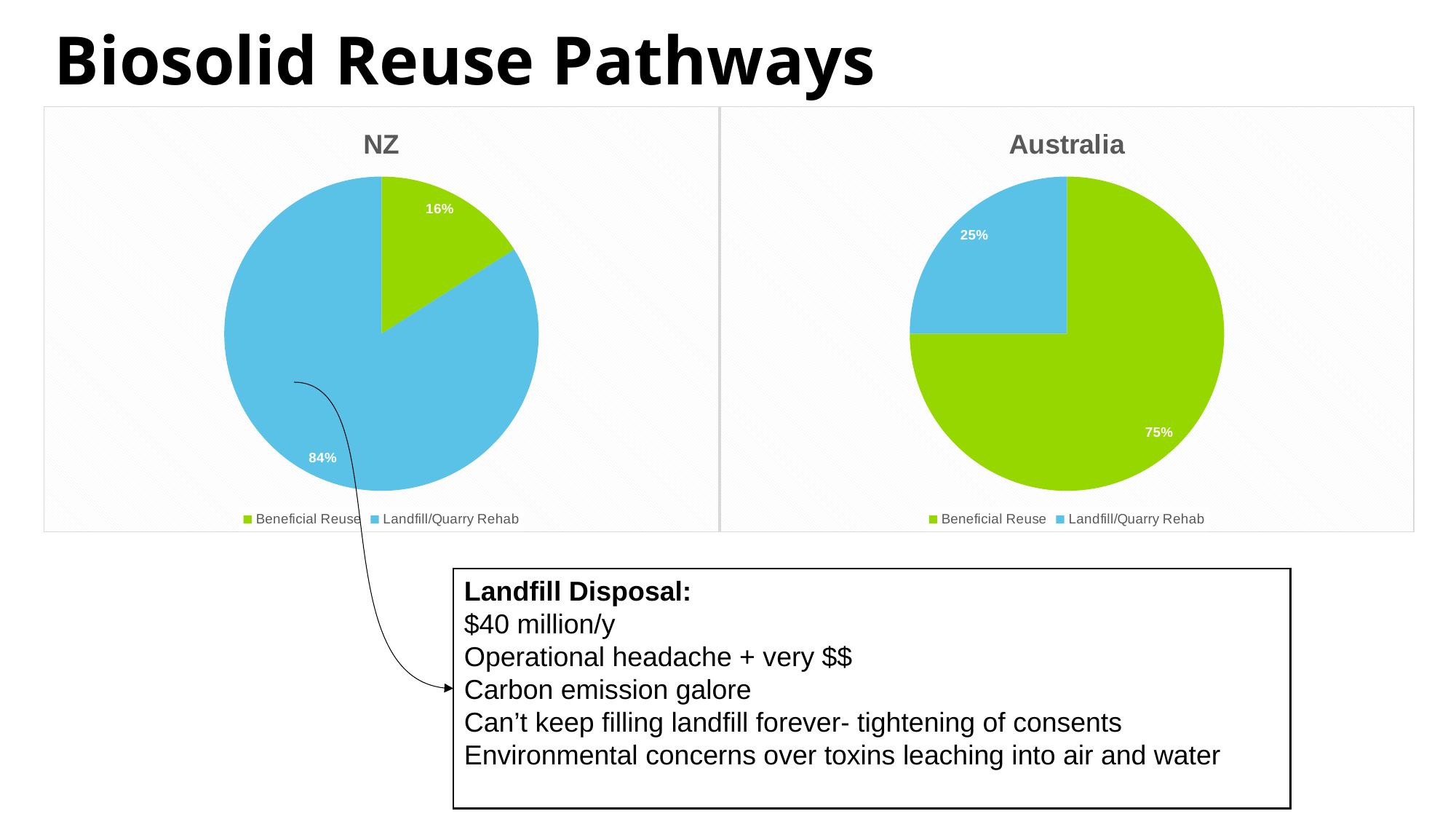
In the Australia chart, what colour is the Beneficial Reuse slice? Green Which is larger: the Beneficial Reuse share in the Australia chart or the Beneficial Reuse share in the NZ chart? Australia In the NZ chart, what share of biosolids goes to Beneficial Reuse? 16% In the Australia chart, which category has the smallest slice? Landfill/Quarry Rehab What kind of chart is the NZ chart? Pie chart In the NZ chart, what share of biosolids goes to Landfill/Quarry Rehab? 84% What is the title of the chart on the right side of the slide? Australia How many categories does the Australia chart's legend list? 2 In the Australia chart, what share of biosolids goes to Beneficial Reuse? 75% In the NZ chart, what is the difference between the Landfill/Quarry Rehab share and the Beneficial Reuse share? 68% In the NZ chart, which category has the largest slice? Landfill/Quarry Rehab In the Australia chart, what share of biosolids goes to Landfill/Quarry Rehab? 25%